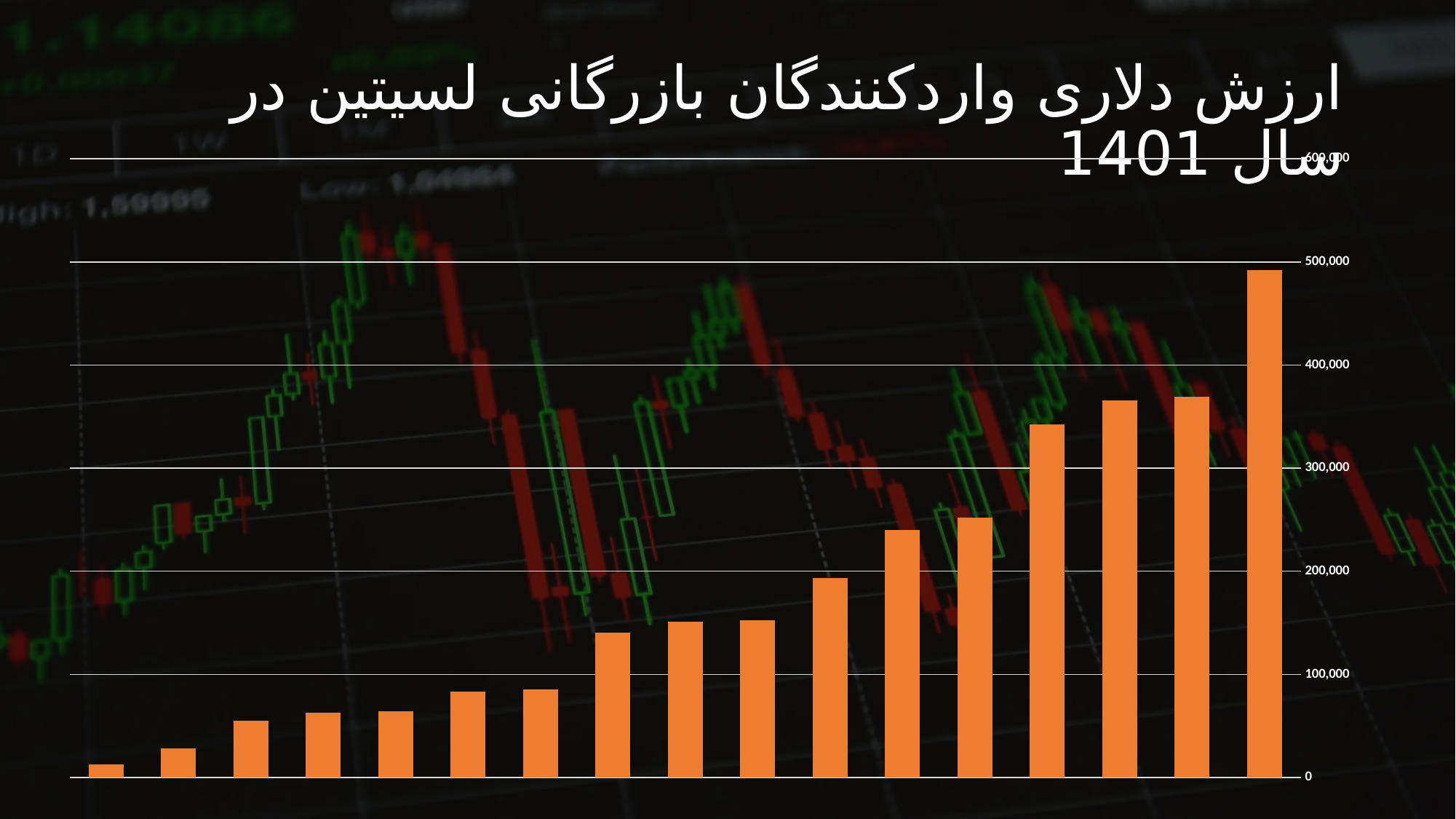
Is the value of the rightmost bar greater or less than 400,000? greater Is the value of the sixth bar from the right greater or less than 300,000? less How many bars are plotted in the chart? 17 Do the bar values generally rise or fall from left to right along the x axis? rise Which bar has the highest value in the chart? the rightmost bar Is the value of the fourth bar from the right greater or less than 300,000? greater What is the highest value shown on the vertical axis? 600,000 What colour are the bars in the chart? orange Which is larger, the rightmost bar or the leftmost bar? the rightmost bar What kind of chart is shown on the slide? bar chart Which bar has the lowest value in the chart? the leftmost bar